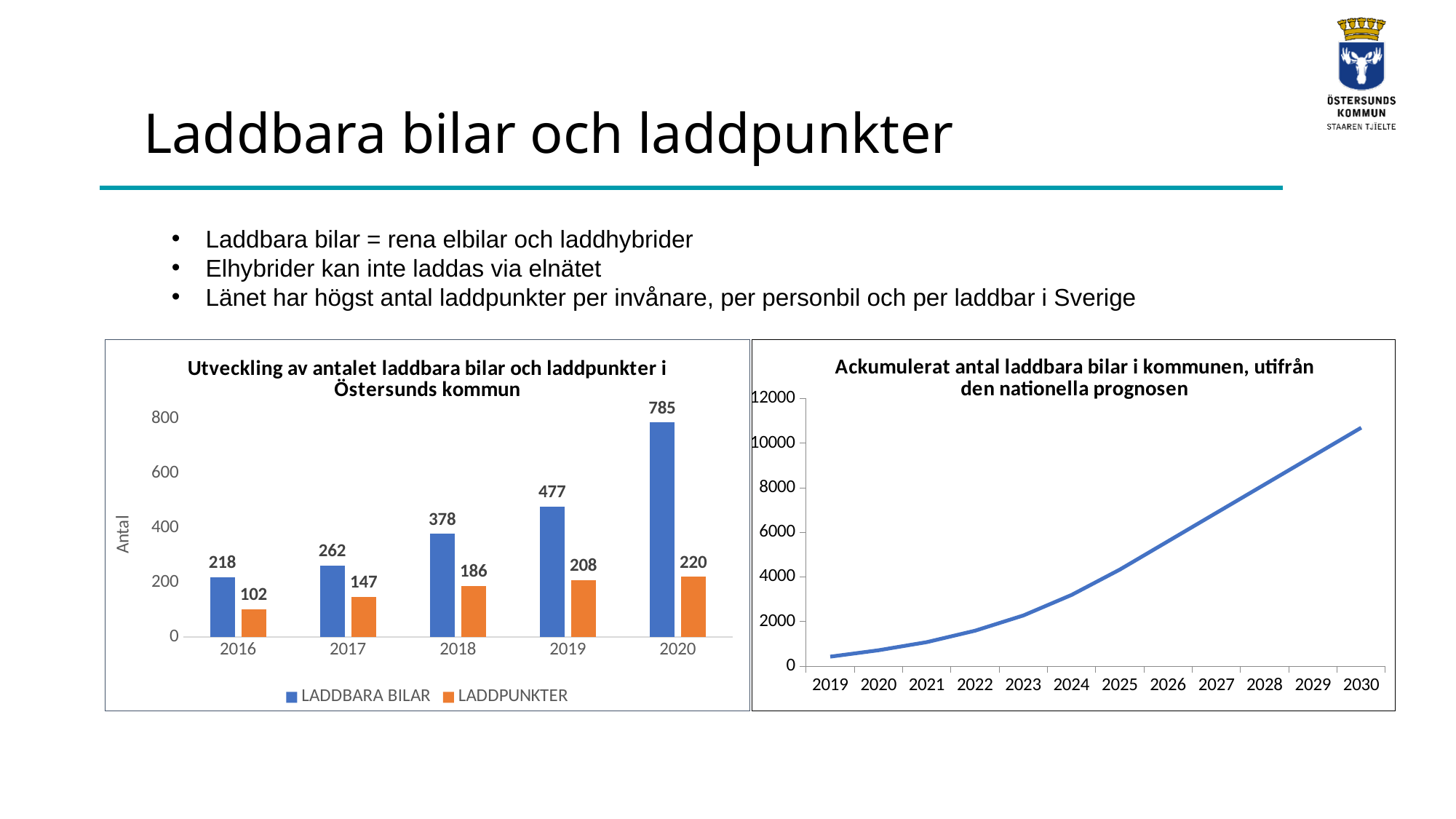
In the left chart 'Utveckling av antalet laddbara bilar och laddpunkter i Östersunds kommun', which year has the highest value for LADDBARA BILAR? 2020 In the left chart 'Utveckling av antalet laddbara bilar och laddpunkter i Östersunds kommun', what is the value for LADDPUNKTER in 2017? 147 In the right chart 'Ackumulerat antal laddbara bilar i kommunen, utifrån den nationella prognosen', is the value for 2030 greater or less than 10000? greater In the left chart 'Utveckling av antalet laddbara bilar och laddpunkter i Östersunds kommun', what is the value for LADDBARA BILAR in 2018? 378 What kind of chart is the right chart 'Ackumulerat antal laddbara bilar i kommunen, utifrån den nationella prognosen'? Line chart In the left chart 'Utveckling av antalet laddbara bilar och laddpunkter i Östersunds kommun', how many years are shown on the x axis? 5 In the left chart 'Utveckling av antalet laddbara bilar och laddpunkter i Östersunds kommun', how many series does the legend list? 2 In the left chart 'Utveckling av antalet laddbara bilar och laddpunkter i Östersunds kommun', which is larger: LADDPUNKTER in 2019 or LADDPUNKTER in 2018? LADDPUNKTER in 2019 In the left chart 'Utveckling av antalet laddbara bilar och laddpunkter i Östersunds kommun', what is the difference between LADDBARA BILAR and LADDPUNKTER in 2020? 565 In the right chart 'Ackumulerat antal laddbara bilar i kommunen, utifrån den nationella prognosen', do the values rise or fall from 2019 to 2030? Rise What kind of chart is the left chart 'Utveckling av antalet laddbara bilar och laddpunkter i Östersunds kommun'? Bar chart In the left chart 'Utveckling av antalet laddbara bilar och laddpunkter i Östersunds kommun', which year has the lowest value for LADDPUNKTER? 2016